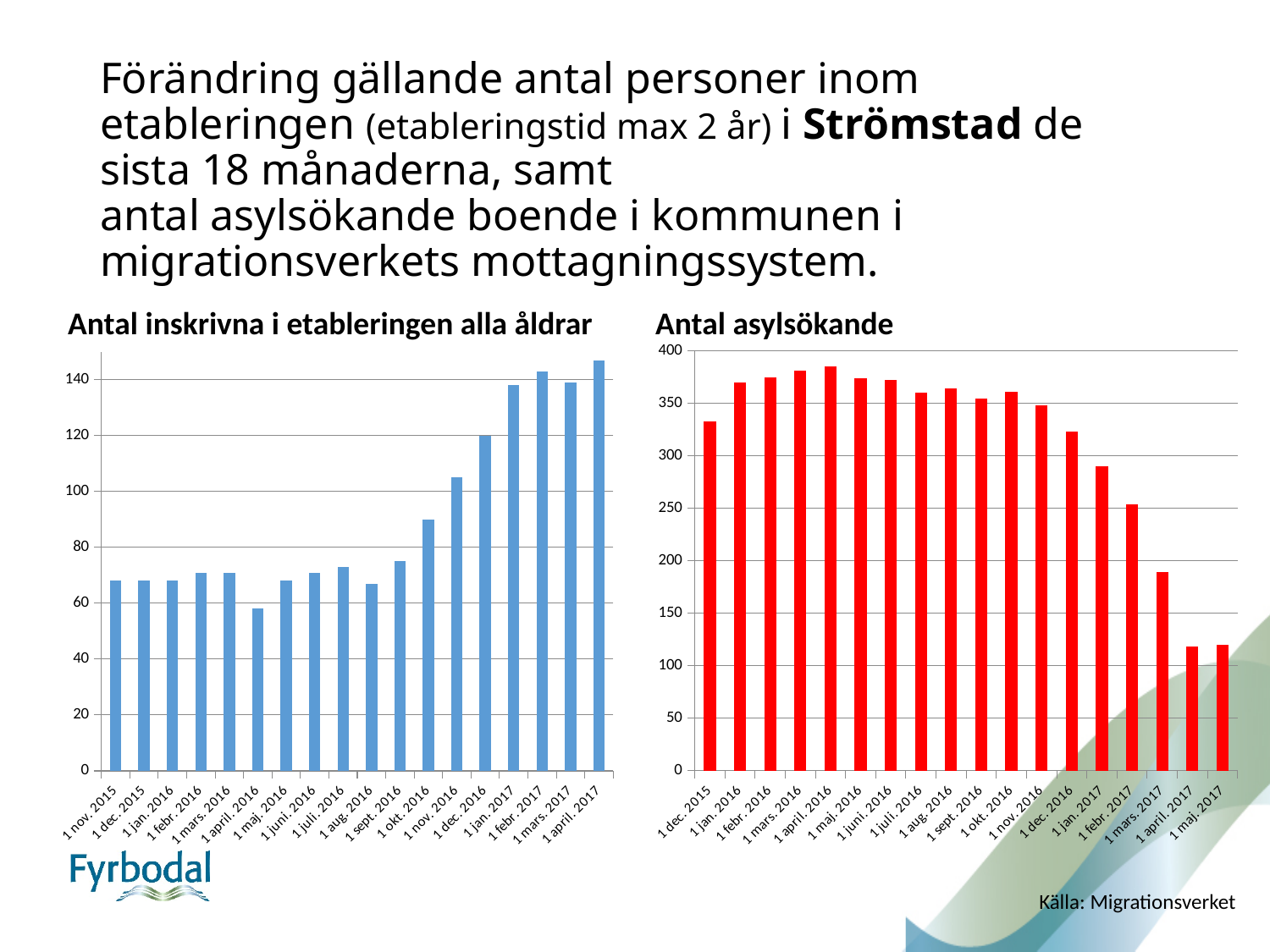
In the "Antal asylsökande" chart, which is larger, the value for 1 dec. 2016 or the value for 1 jan. 2017? 1 dec. 2016 How many months (bars) are shown in the "Antal inskrivna i etableringen alla åldrar" chart? 18 In the "Antal inskrivna i etableringen alla åldrar" chart, do the values overall rise or fall from 1 nov. 2015 to 1 april 2017? rise How many months (bars) are shown in the "Antal asylsökande" chart? 18 What colour are the bars in the "Antal asylsökande" chart? red What kind of chart is the "Antal inskrivna i etableringen alla åldrar" chart on the left? bar chart In the "Antal inskrivna i etableringen alla åldrar" chart, is the value for 1 nov. 2016 greater or less than 100? greater In the "Antal inskrivna i etableringen alla åldrar" chart, which month has the lowest value? 1 april 2016 In the "Antal asylsökande" chart, is the value for 1 mars 2017 greater or less than 200? less In the "Antal inskrivna i etableringen alla åldrar" chart, is the value for 1 april 2016 greater or less than 80? less In the "Antal asylsökande" chart, do the values overall rise or fall from 1 dec. 2015 to 1 maj 2017? fall In the "Antal inskrivna i etableringen alla åldrar" chart, which month has the highest value? 1 april 2017